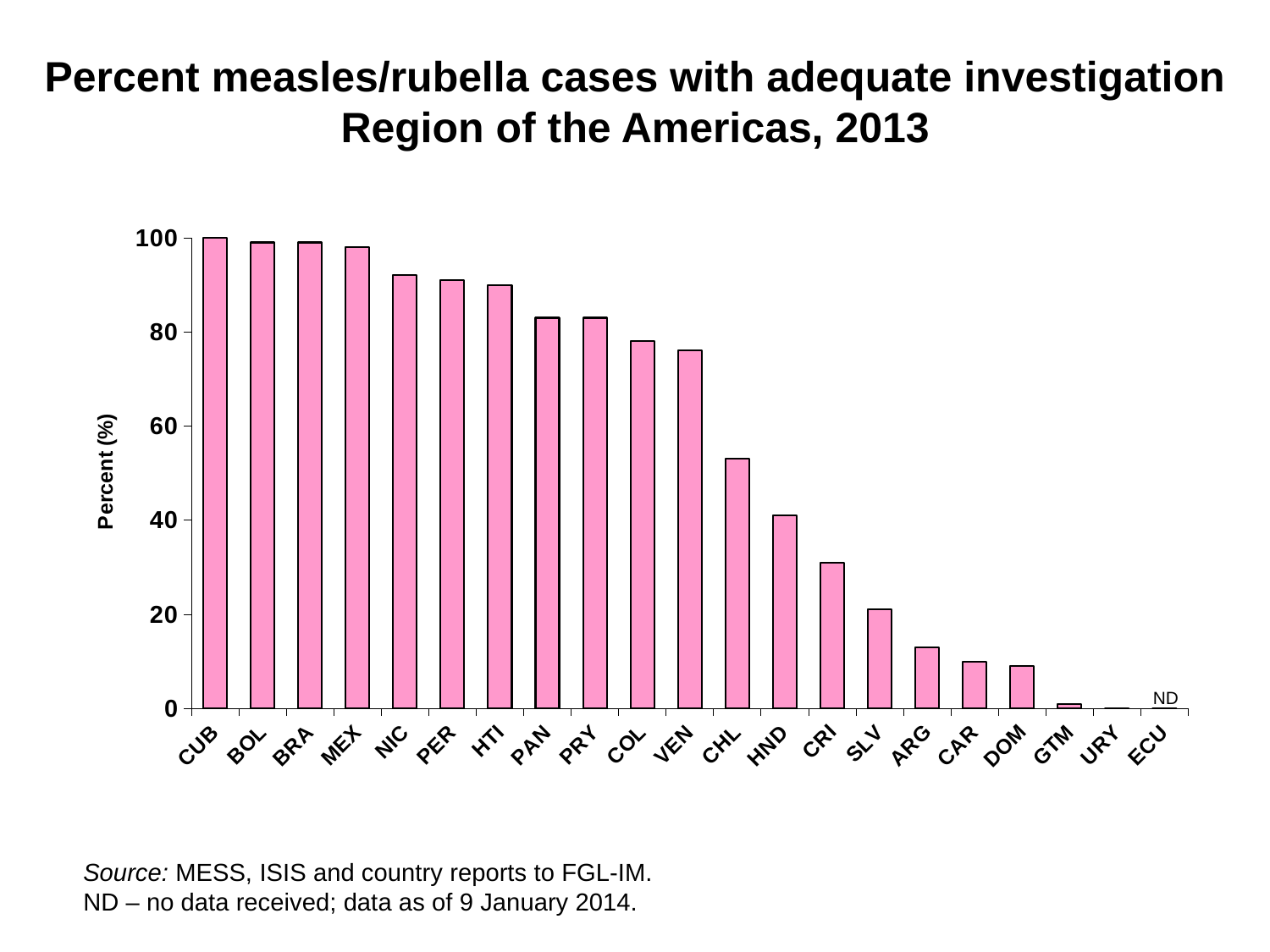
Is the value for VEN greater or less than 80? less Do the values rise or fall moving from left to right along the x axis? fall What kind of chart is shown on the slide? bar chart Which country has the highest percent of measles/rubella cases with adequate investigation? CUB What is the value for CUB? 100 Which country is marked ND (no data received) on the chart? ECU Is the value for CRI greater or less than 40? less Is the value for CHL greater or less than 40? greater Which has a larger value, CHL or HND? CHL How many countries are shown along the x axis? 21